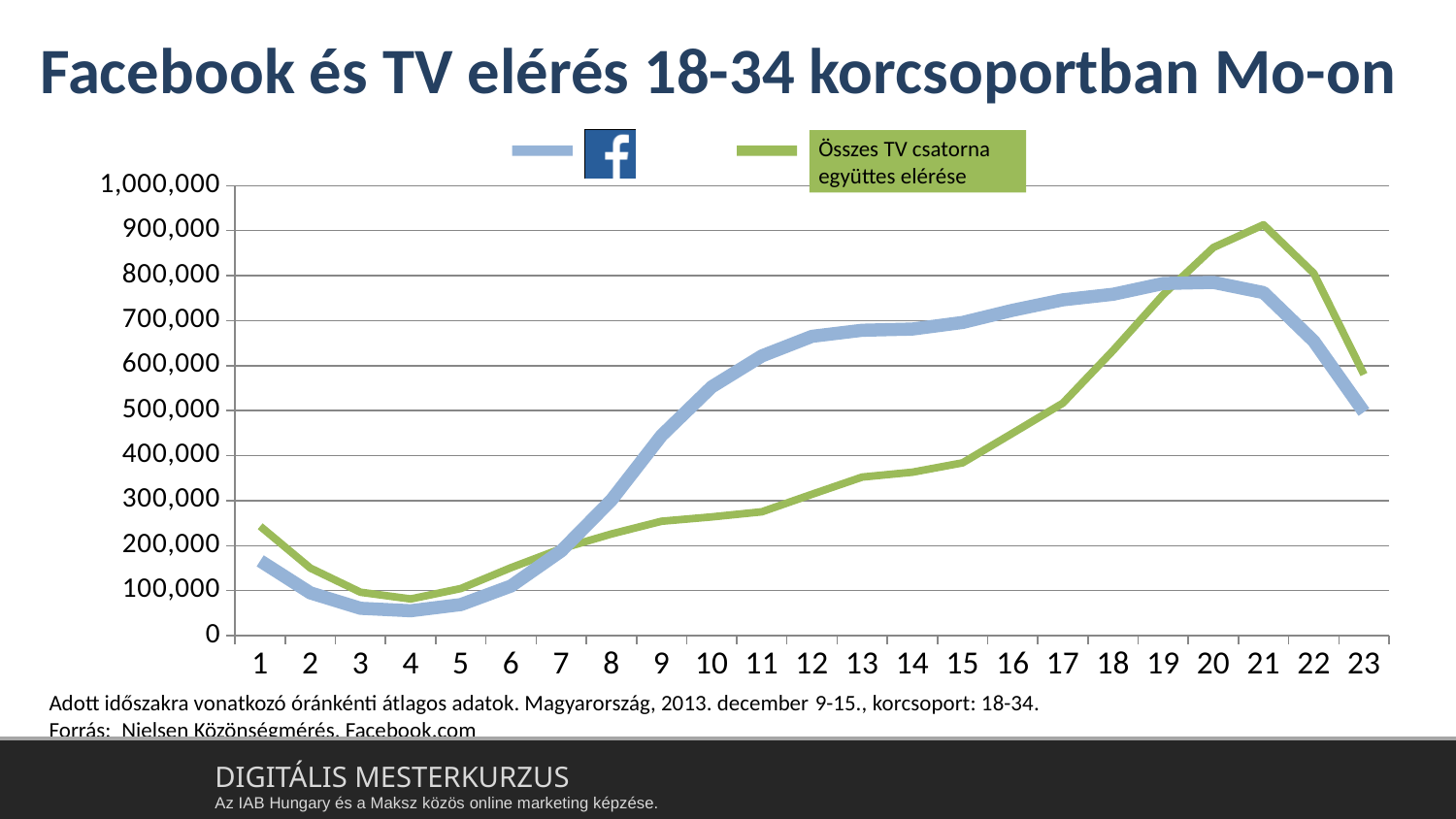
At which hour does the 'Összes TV csatorna együttes elérése' series reach its highest value? 21 Is the Facebook value at hour 22 greater or less than 600,000? greater How many points (hours) are shown along the x axis? 23 What kind of chart is shown on the slide? line chart How many series does the legend list? 2 Is the 'Összes TV csatorna együttes elérése' value at hour 20 greater or less than 800,000? greater What is the legend label of the green series? Összes TV csatorna együttes elérése At hour 12, which series has the larger value, Facebook or 'Összes TV csatorna együttes elérése'? Facebook At hour 21, which series has the larger value, Facebook or 'Összes TV csatorna együttes elérése'? Összes TV csatorna együttes elérése Is the Facebook value at hour 10 greater or less than 500,000? greater Does the Facebook series rise or fall between hour 4 and hour 20? rise